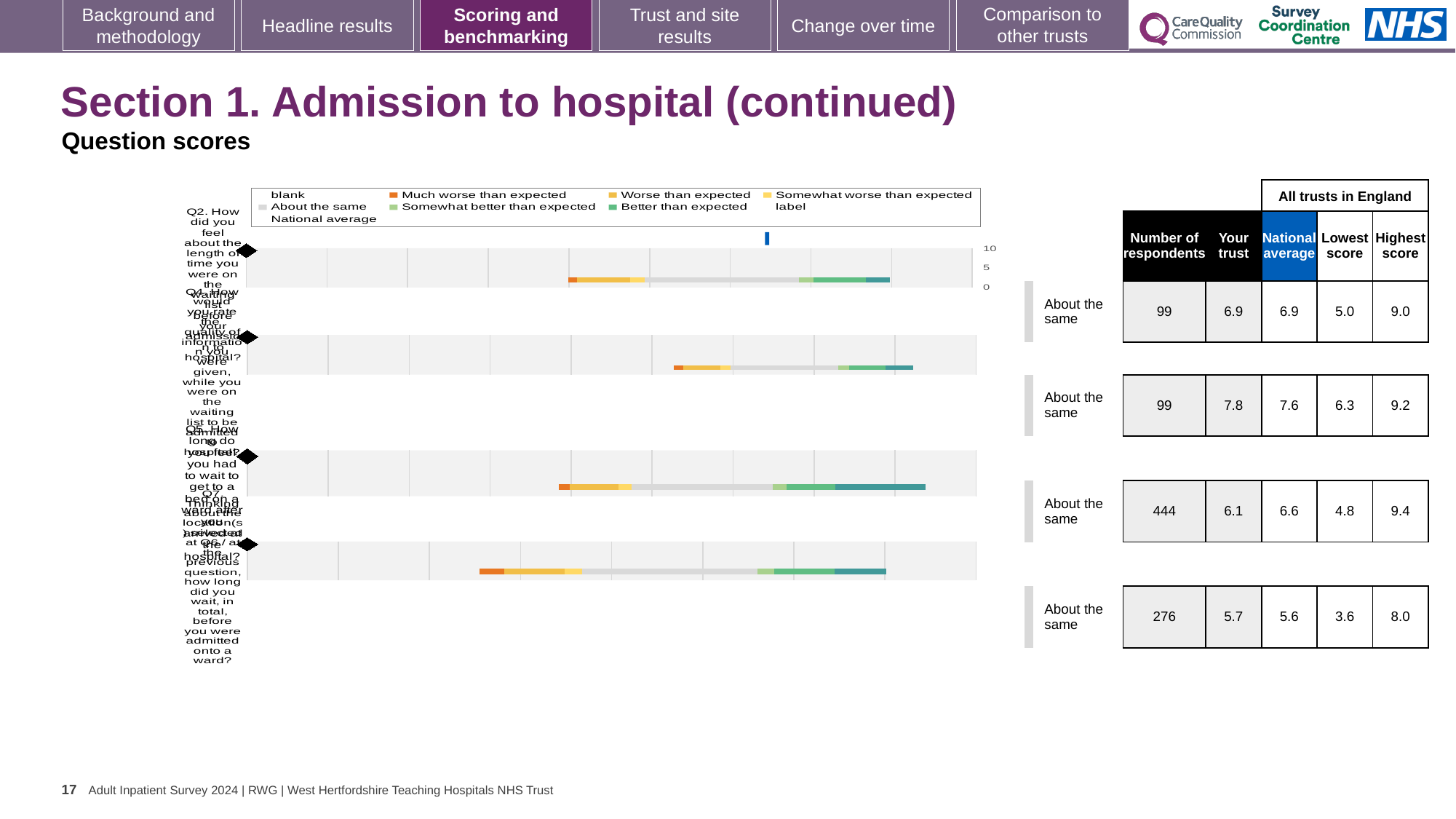
In the table beside the chart, what is the lowest score in the fourth row? 3.6 In the table beside the chart, what is the number of respondents in the third row? 444 In the table beside the chart, in the second row, which is larger: "Your trust" or "National average"? Your trust What kind of chart is shown on the slide? bar chart In the table beside the chart, which row has the lowest "Lowest score" value? fourth row (3.6) How many bars are plotted in the chart? 4 What colour represents "Much worse than expected" in the chart legend? orange What is the highest value shown on the chart's axis? 10 In the table beside the chart, what is the "Your trust" score in the first row? 6.9 What benchmark label is shown next to each bar in the chart? About the same In the table beside the chart, what is the difference between "Your trust" and "National average" in the fourth row? 0.1 In the table beside the chart, which row has the highest "Highest score" value? third row (9.4)